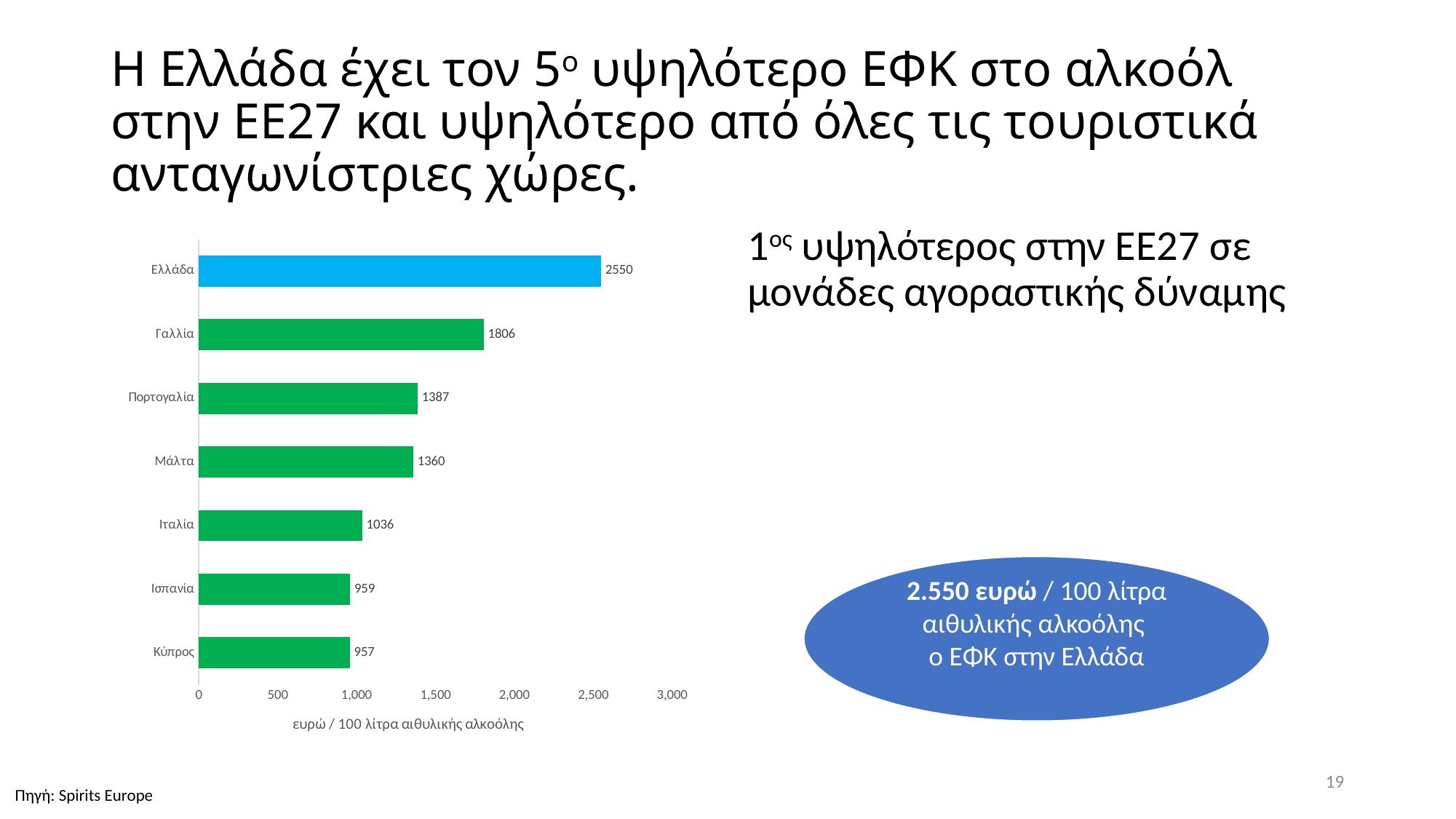
Which country has the highest value? Ελλάδα What is the value for Ιταλία? 1036 What is the difference between the values for Ελλάδα and Γαλλία? 744 What is the difference between the values for Πορτογαλία and Μάλτα? 27 What is the value for Ελλάδα? 2550 Which country has the lowest value? Κύπρος What is the value for Γαλλία? 1806 How many countries are shown in the chart? 7 Is the value for Γαλλία greater or less than 1,500? greater What kind of chart is shown on the slide? bar chart Which is larger, the value for Ιταλία or the value for Ισπανία? Ιταλία What is the x-axis label of the chart? ευρώ / 100 λίτρα αιθυλικής αλκοόλης